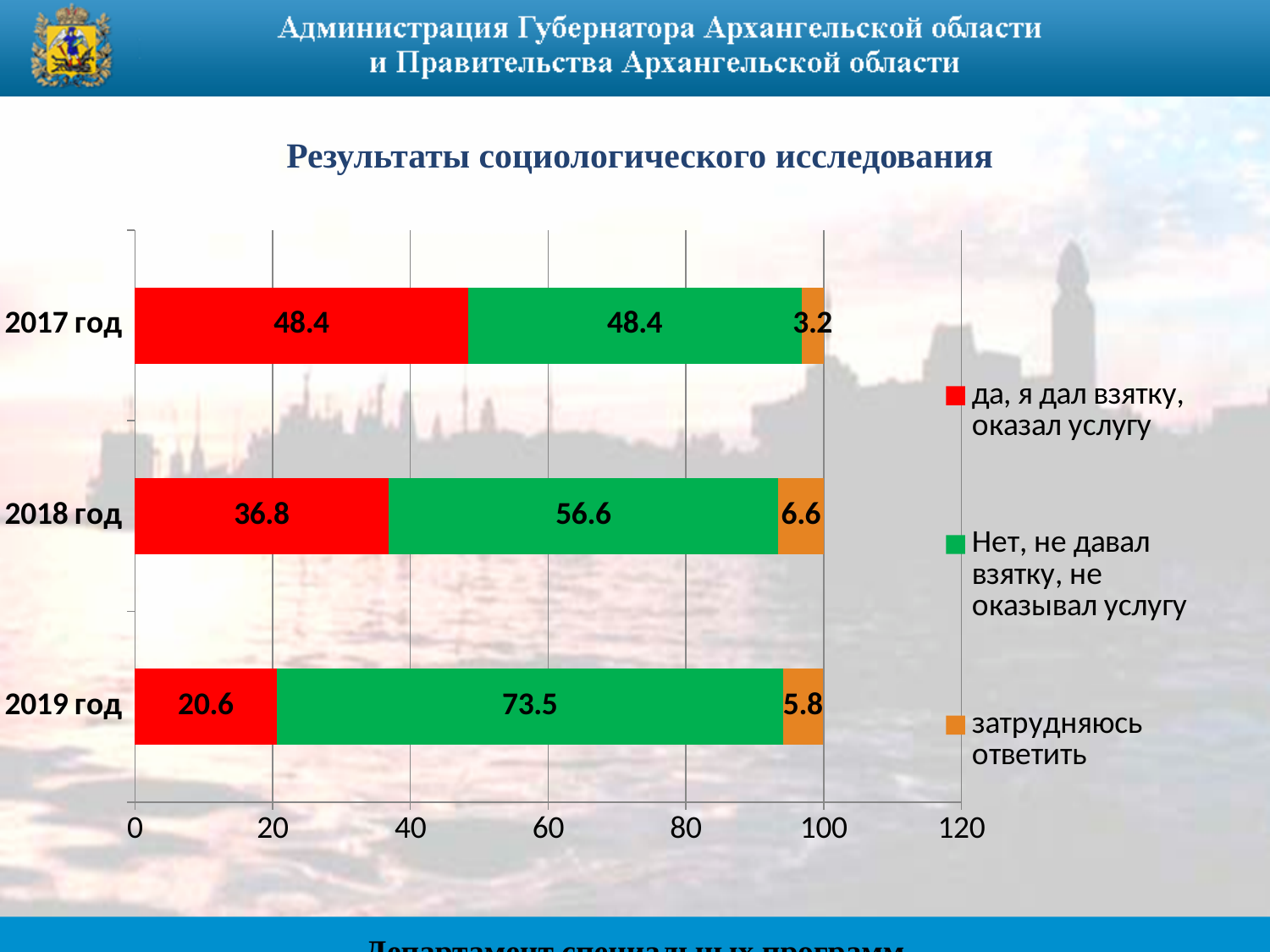
What kind of chart is shown on the slide? Stacked bar chart In which year is the value for "да, я дал взятку, оказал услугу" lowest? 2019 год Which is larger: the "затрудняюсь ответить" value for 2018 год or for 2019 год? 2018 год What is the total of the stacked bar for 2018 год? 100 What is the difference between the "Нет, не давал взятку, не оказывал услугу" values for 2019 год and 2017 год? 25.1 How many years (categories) are shown on the chart? 3 Does the value for "да, я дал взятку, оказал услугу" rise or fall from 2017 год to 2019 год? Fall How many series does the legend list? 3 What is the value for "затрудняюсь ответить" in 2017 год? 3.2 What is the value for "да, я дал взятку, оказал услугу" in 2019 год? 20.6 In which year is the value for "Нет, не давал взятку, не оказывал услугу" highest? 2019 год What is the value for "Нет, не давал взятку, не оказывал услугу" in 2018 год? 56.6